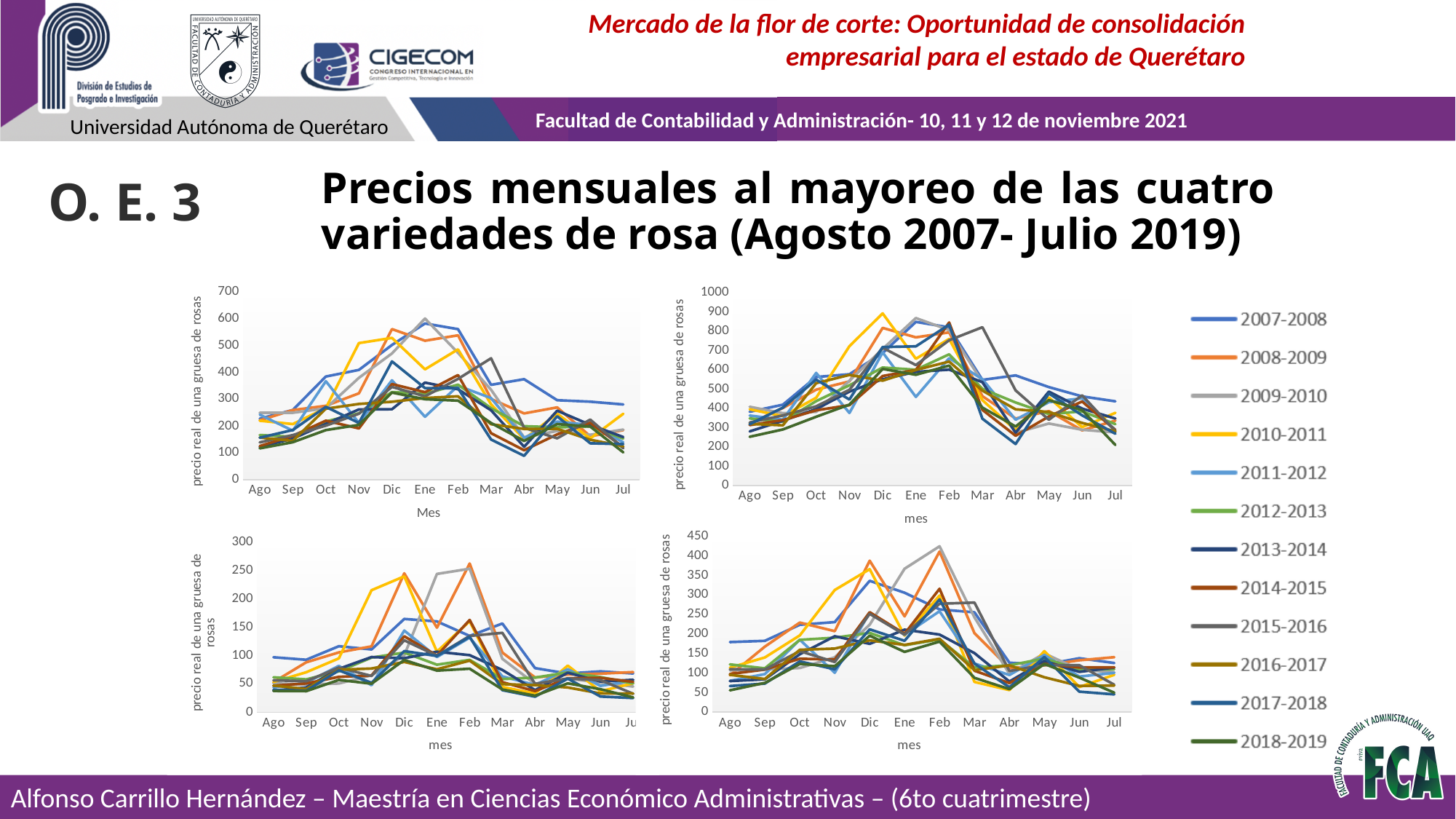
What is the first month shown on the x axis of the bottom-left chart? Ago In the top-left chart, is the value for the 2009-2010 series in Ene greater or less than 500? greater In the top-right chart, is the value for the 2010-2011 series in Dic greater or less than 800? greater In the bottom-left chart, is the value for the 2008-2009 series in Feb greater or less than 200? greater How many series does the legend on the right of the slide list? 12 What kind of chart is the top-left chart on the slide? Line chart How many months are shown along the x axis of the top-right chart? 12 What is the highest tick value on the y axis of the top-right chart? 1000